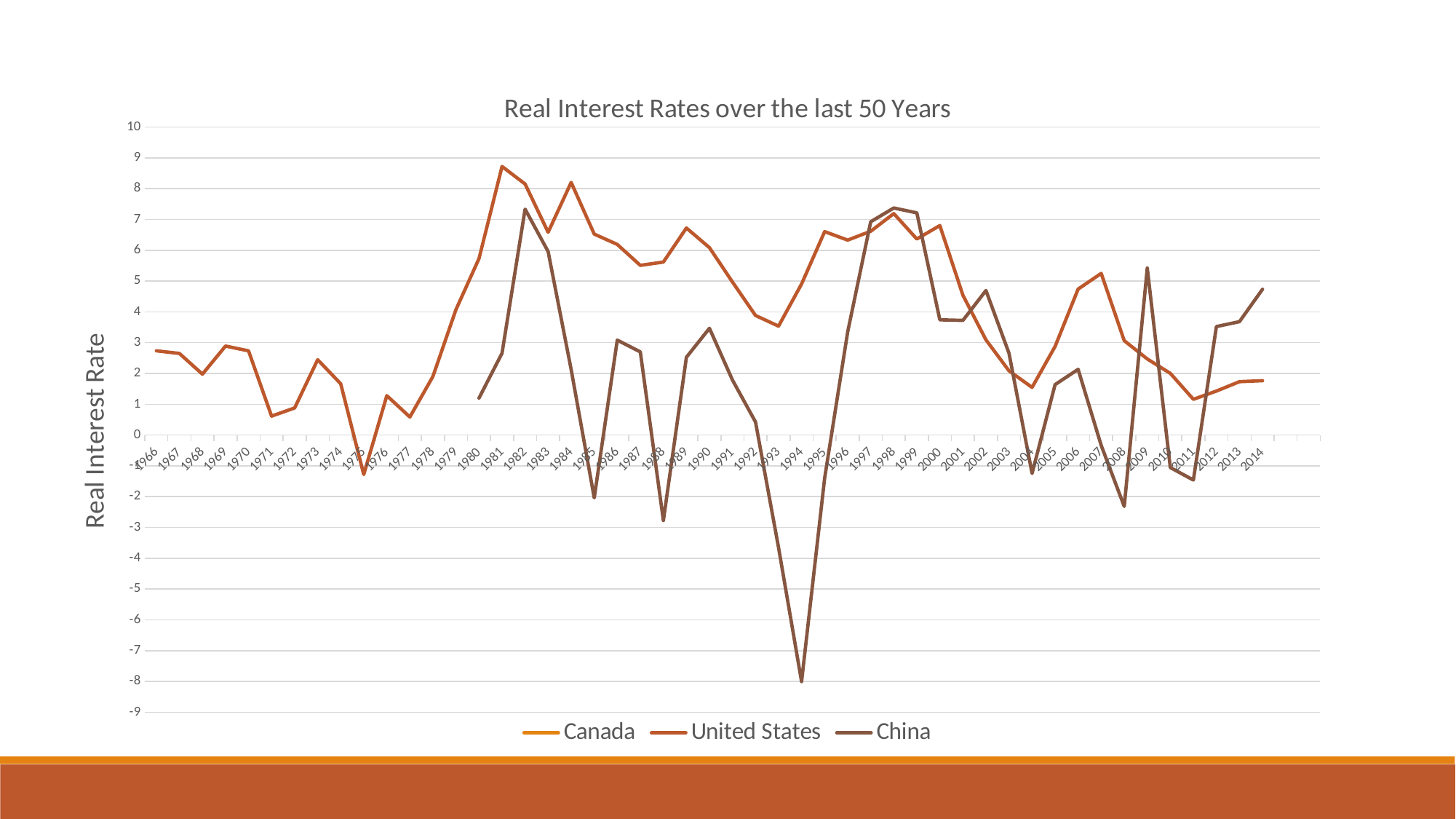
In which year does the China line reach its lowest value? 1994 Is the value for China in 1994 greater or less than -7? less How many years are labelled along the x axis? 49 What kind of chart is shown on the slide? line chart Is the value for the United States in 1975 greater or less than 0? less Does the United States line rise or fall from 1978 to 1981? rise What is the label on the vertical axis? Real Interest Rate Is the value for the United States in 1981 greater or less than 8? greater In which year does the United States line reach its highest value? 1981 In 1994, which series has the larger value, United States or China? United States How many series does the legend list? 3 What is the title of the chart? Real Interest Rates over the last 50 Years